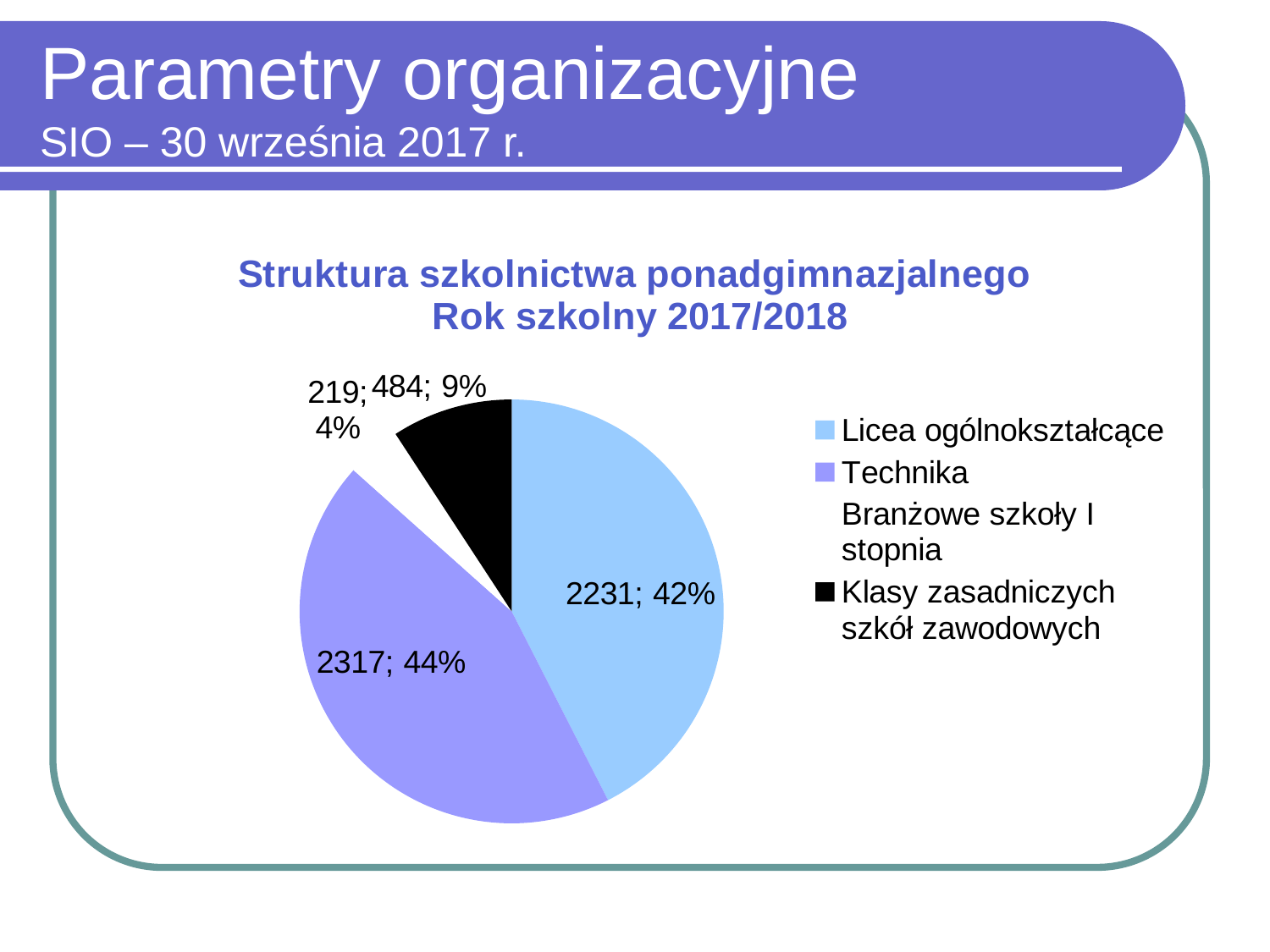
What percentage share does Technika have? 44% What value is shown for Licea ogólnokształcące? 2231 What value and share are shown for Branżowe szkoły I stopnia? 219; 4% Which category has the largest slice? Technika What is the title of the chart? Struktura szkolnictwa ponadgimnazjalnego Rok szkolny 2017/2018 Which category has the smallest slice? Branżowe szkoły I stopnia What percentage share does Licea ogólnokształcące have? 42% What type of chart is shown on the slide? pie chart How many categories does the legend list? 4 What value is shown for Technika? 2317 What is the difference between the values for Technika and Licea ogólnokształcące? 86 What value and share are shown for Klasy zasadniczych szkół zawodowych? 484; 9%